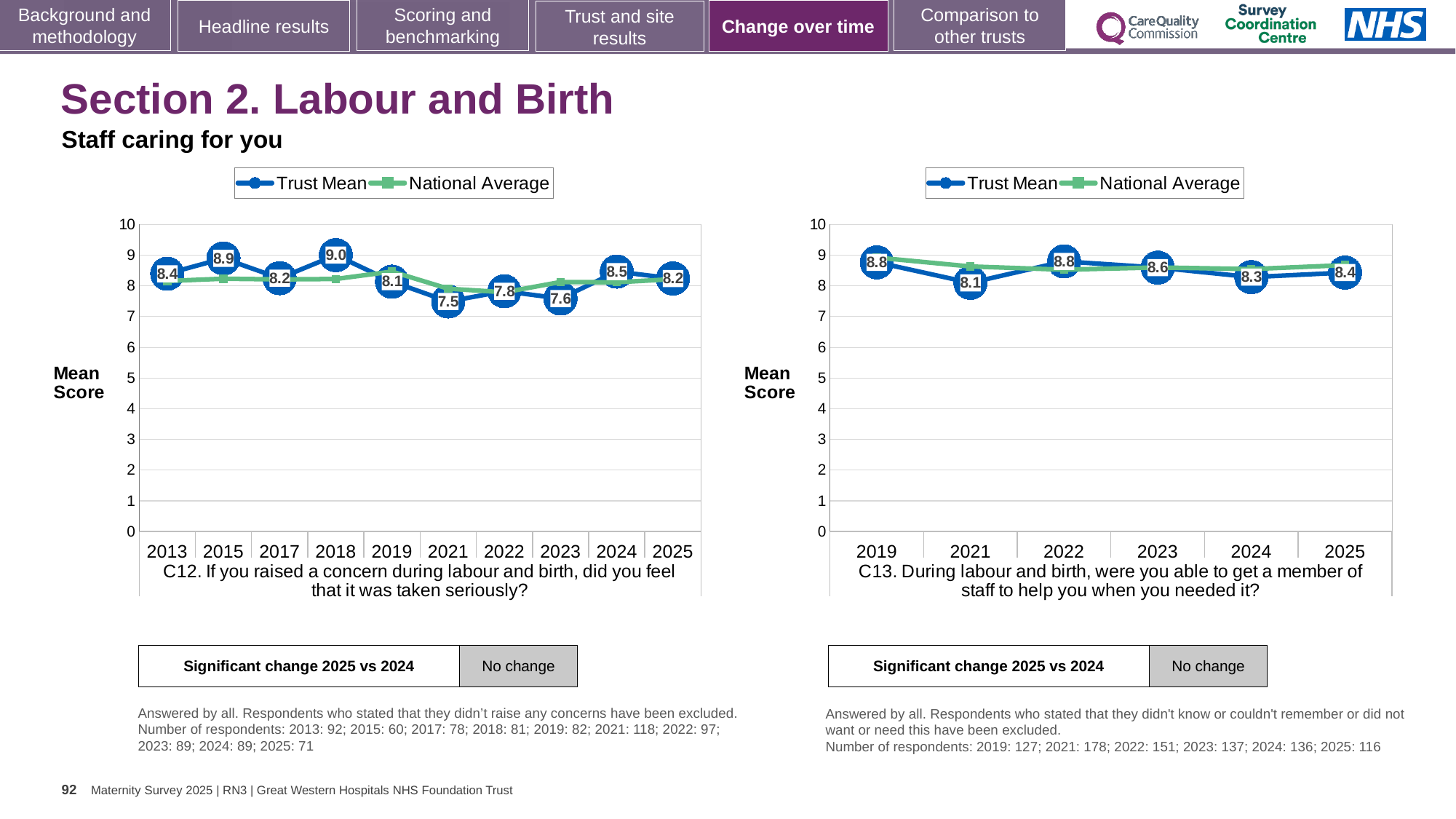
What type of chart is the C13 chart on the right? Line chart In the C13 chart on the right, what is the difference between the Trust Mean in 2019 and in 2021? 0.7 In the C13 chart on the right, which year has the lowest Trust Mean? 2021 In the C12 chart on the left, does the Trust Mean rise or fall from 2018 to 2021? Fall How many years are plotted in the C12 chart on the left? 10 In the C12 chart on the left, what is the Trust Mean for 2021? 7.5 In the C12 chart on the left, what is the Trust Mean for 2018? 9.0 In the C12 chart on the left, what is the difference between the Trust Mean in 2018 and in 2021? 1.5 In the C13 chart on the right, what is the Trust Mean for 2025? 8.4 How many series does the legend of the C13 chart on the right list? 2 In the C12 chart on the left, which year has the larger Trust Mean, 2015 or 2024? 2015 In the C12 chart on the left, which year has the highest Trust Mean? 2018